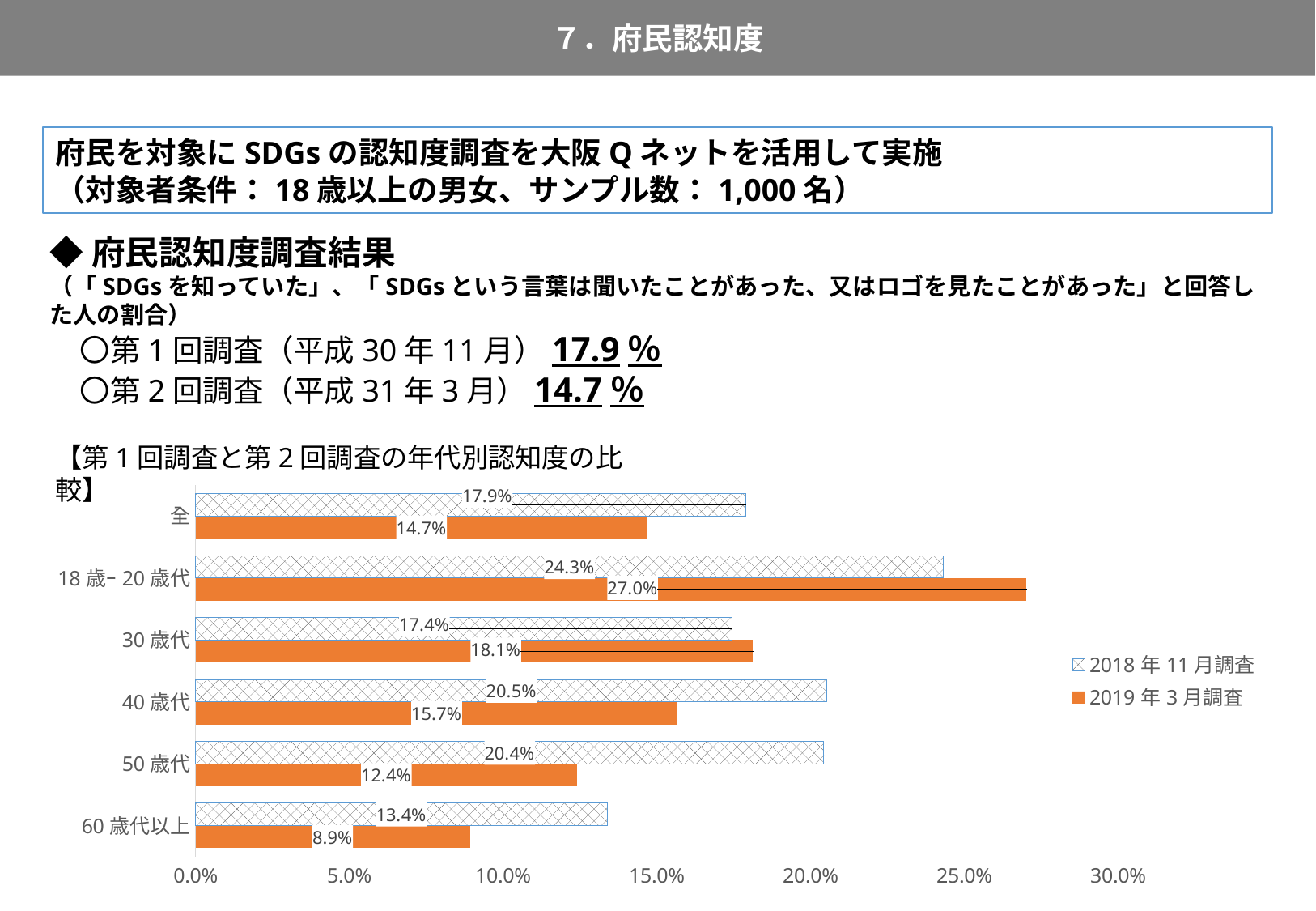
Is the 2018年11月調査 value for 40歳代 greater or less than 15.0%? greater For 30歳代, which series has the larger value, 2018年11月調査 or 2019年3月調査? 2019年3月調査 What is the value for 18歳-20歳代 in the 2019年3月調査 series? 27.0% What is the value for 60歳代以上 in the 2019年3月調査 series? 8.9% How many series does the chart legend list? 2 How many age categories are plotted on the chart? 6 What is the value for 50歳代 in the 2018年11月調査 series? 20.4% What kind of chart is shown on the slide? bar chart Which age category has the highest value in the 2018年11月調査 series? 18歳-20歳代 Which series is drawn in solid orange in the chart? 2019年3月調査 What is the difference between the 2018年11月調査 and 2019年3月調査 values for 50歳代? 8.0% Which age category has the lowest value in the 2019年3月調査 series? 60歳代以上